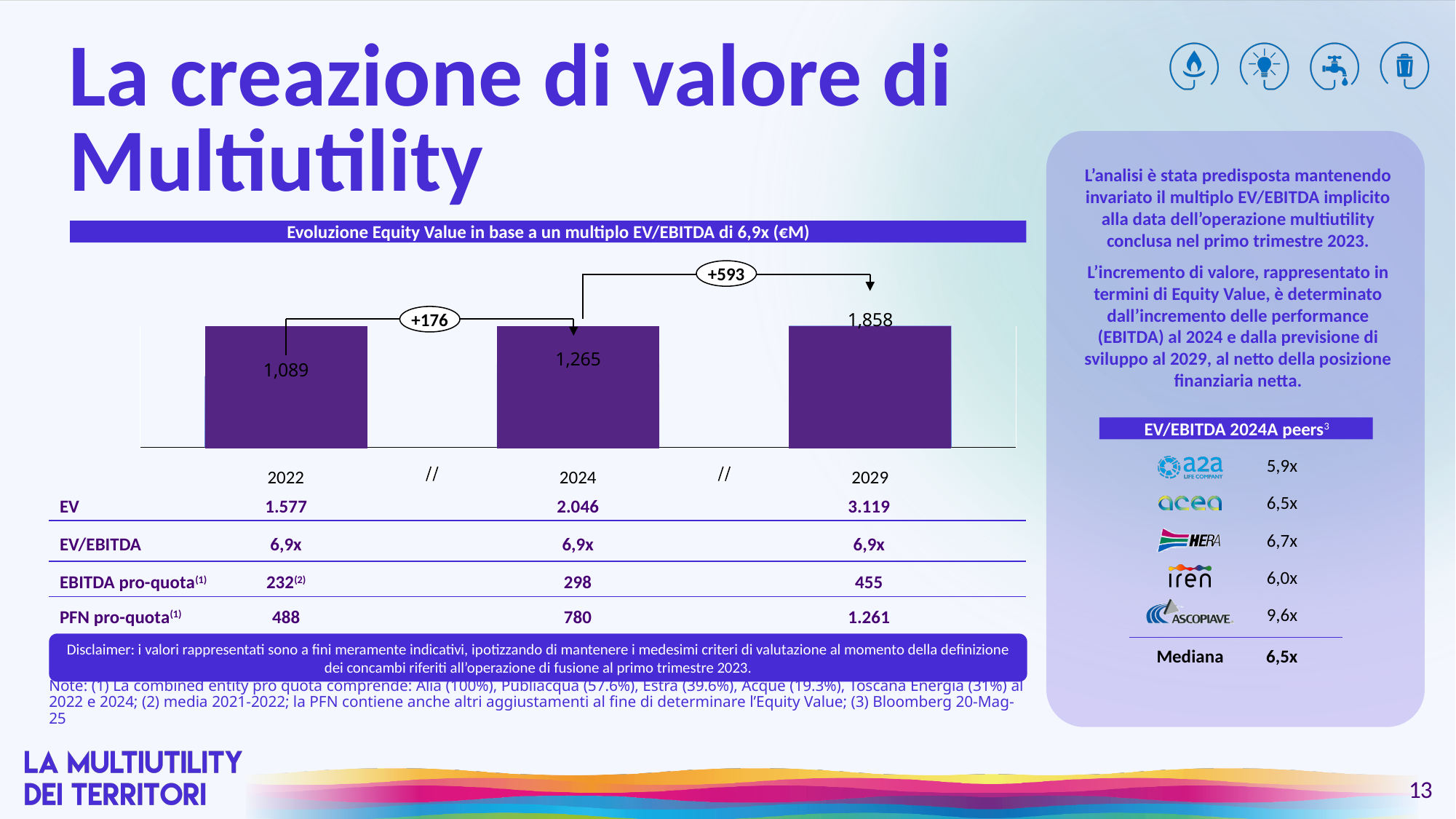
What is the difference between the Equity Value for 2024 and for 2022? 176 Which is larger, the Equity Value for 2029 or for 2022? 2029 Do the Equity Values rise or fall from 2022 to 2029? Rise How many bars are plotted in the chart? 3 What is the Equity Value shown for 2029 in the chart? 1,858 What kind of chart is shown on the slide? Bar chart Which year has the highest Equity Value in the chart? 2029 What is the title of the chart? Evoluzione Equity Value in base a un multiplo EV/EBITDA di 6,9x (€M) Which year has the lowest Equity Value in the chart? 2022 What is the difference between the Equity Value for 2029 and for 2024? 593 What is the Equity Value shown for 2022 in the chart? 1,089 What is the Equity Value shown for 2024 in the chart? 1,265